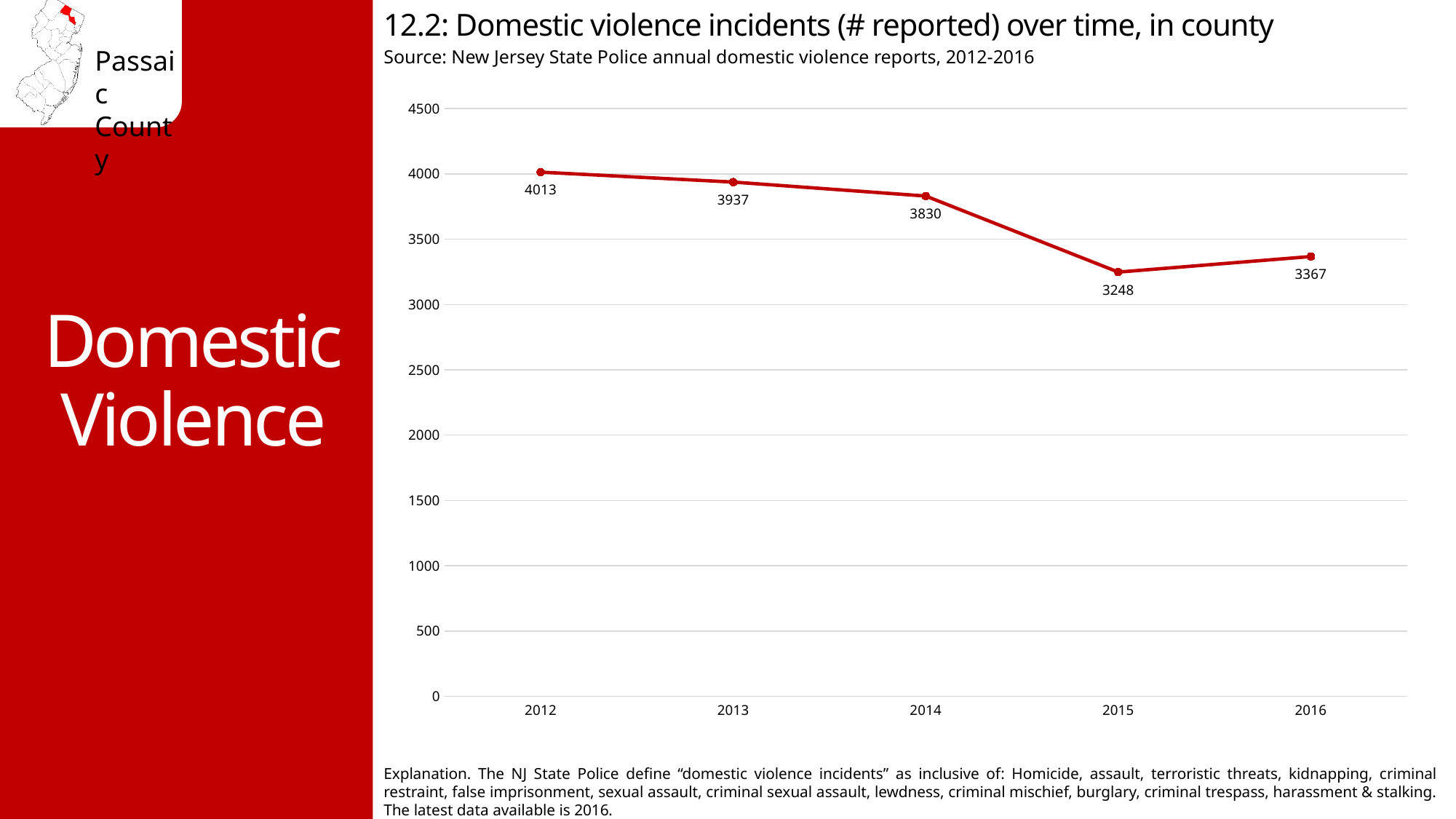
How many years are plotted on the chart? 5 How many domestic violence incidents were reported in 2012? 4013 Which year had more reported incidents, 2013 or 2014? 2013 Is the value for 2015 greater or less than 3500? less What type of chart is shown on the slide? Line chart How many domestic violence incidents were reported in 2015? 3248 What is the difference between the 2012 and 2016 values? 646 What is the overall trend of reported incidents from 2012 to 2015? Falling Which year has the lowest number of reported domestic violence incidents? 2015 What is the value for 2016? 3367 What is the difference between the 2014 and 2015 values? 582 Which year has the highest number of reported domestic violence incidents? 2012